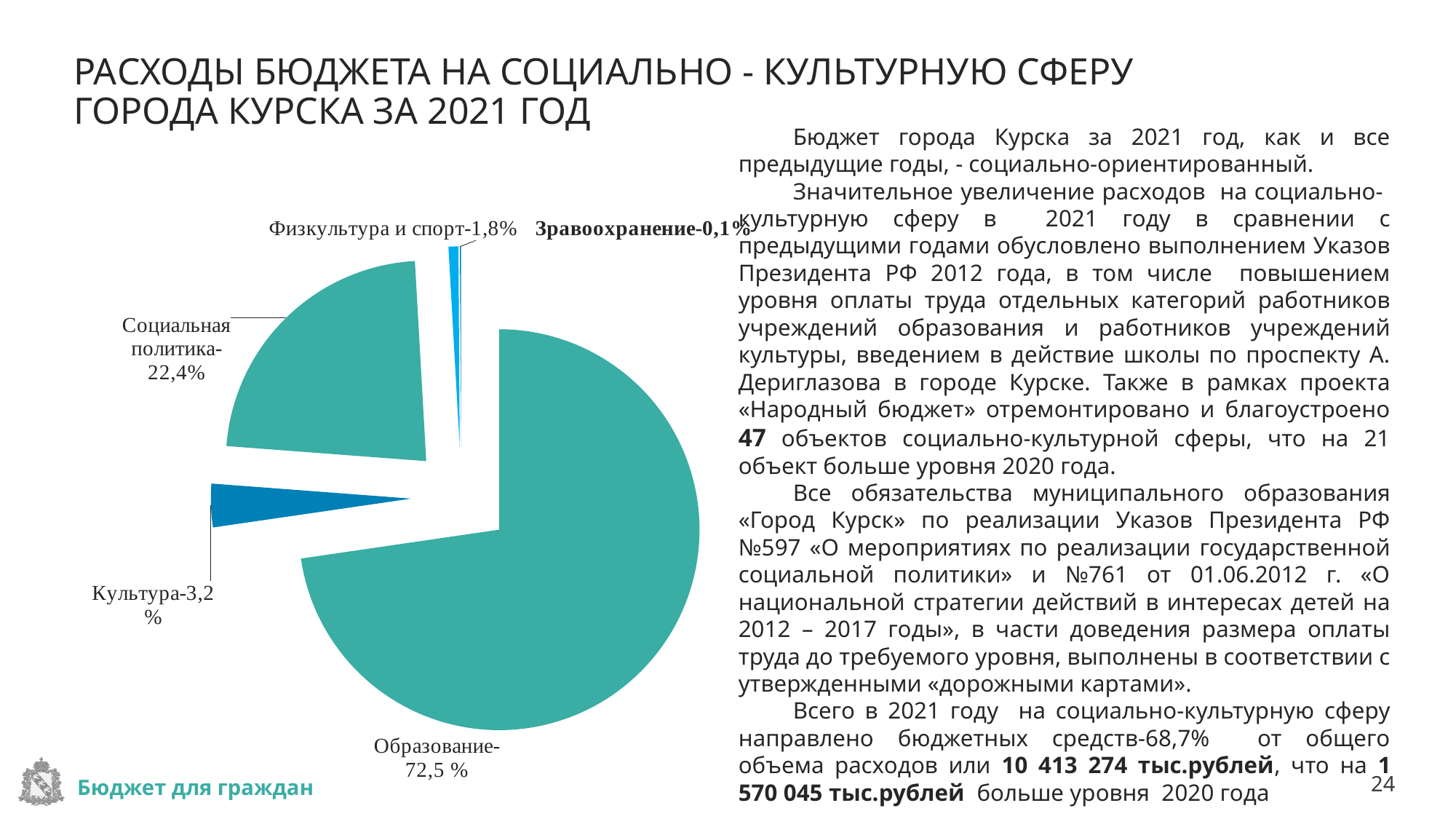
What share of the pie does Образование (education) account for? 72,5 % What share of the pie does Здравоохранение (healthcare) account for? 0,1% Which share is larger: Культура or Физкультура и спорт? Культура By how many percentage points does the share of Социальная политика exceed the share of Культура? 19,2 What share of the pie does Культура (culture) account for? 3,2 % What share of the pie does Физкультура и спорт (physical culture and sport) account for? 1,8% By how many percentage points does the share of Образование exceed the share of Социальная политика? 50,1 Which category has the largest share of the pie? Образование Which category has the smallest share of the pie? Здравоохранение What kind of chart is shown on the slide? Pie chart What share of the pie does Социальная политика (social policy) account for? 22,4% How many slices does the pie chart have? 5